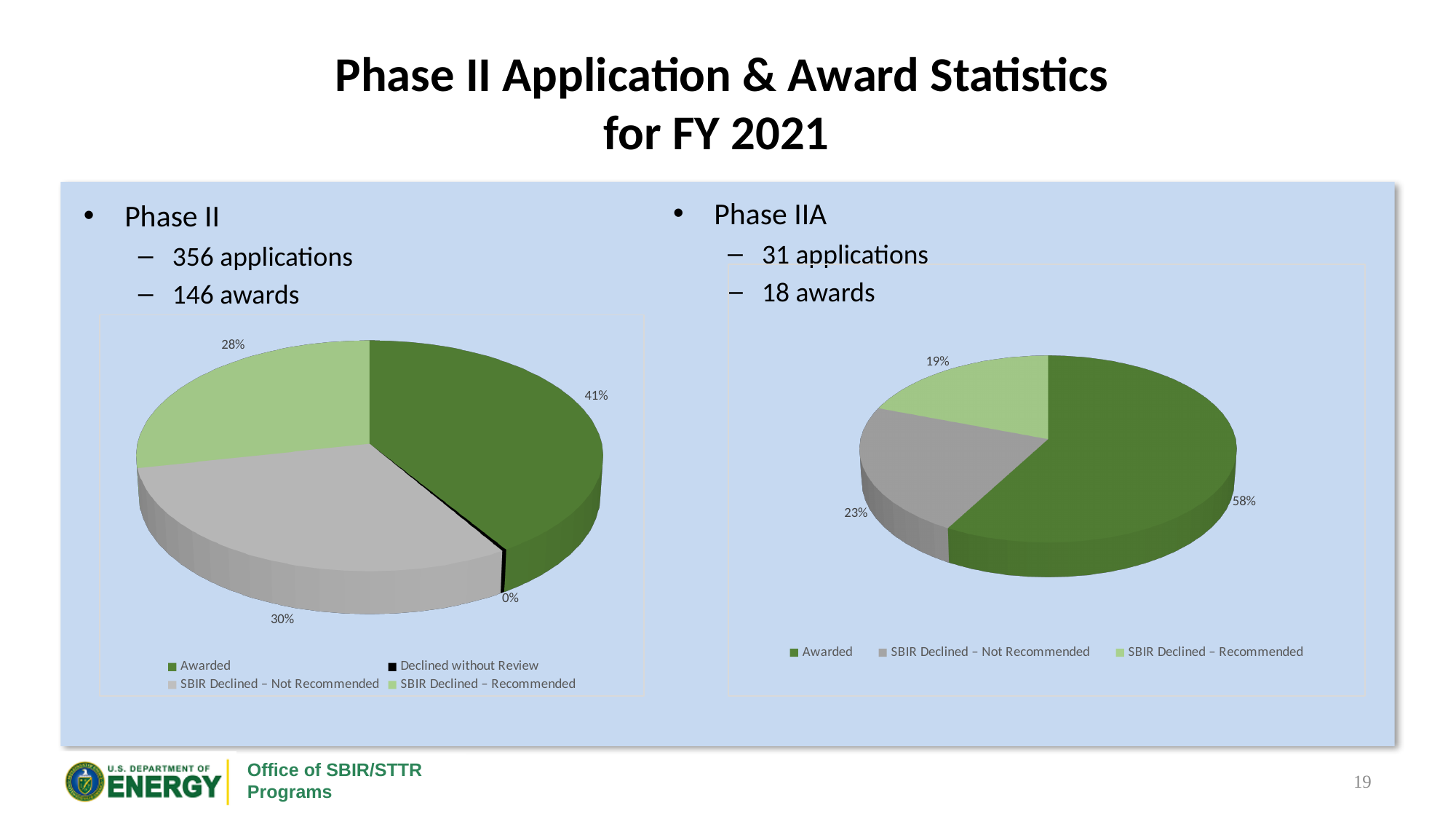
In the right pie chart (Phase IIA), what share is labelled for SBIR Declined – Recommended? 19% In the left pie chart (Phase II), what share is labelled for SBIR Declined – Recommended? 28% In the left pie chart (Phase II), which category has the smallest slice? Declined without Review In the left pie chart (Phase II), what share is labelled for SBIR Declined – Not Recommended? 30% In the right pie chart (Phase IIA), what is the difference between the Awarded share and the SBIR Declined – Not Recommended share? 35% In the right pie chart (Phase IIA), what share is labelled for SBIR Declined – Not Recommended? 23% What kind of chart is used on the right side of the slide for Phase IIA? Pie chart In the right pie chart (Phase IIA), what share is labelled for Awarded? 58% In the left pie chart (Phase II), what share is labelled for Declined without Review? 0% In the right pie chart (Phase IIA), which category has the largest slice? Awarded How many entries does the legend of the left pie chart (Phase II) list? 4 In the left pie chart (Phase II), what share is labelled for Awarded? 41%